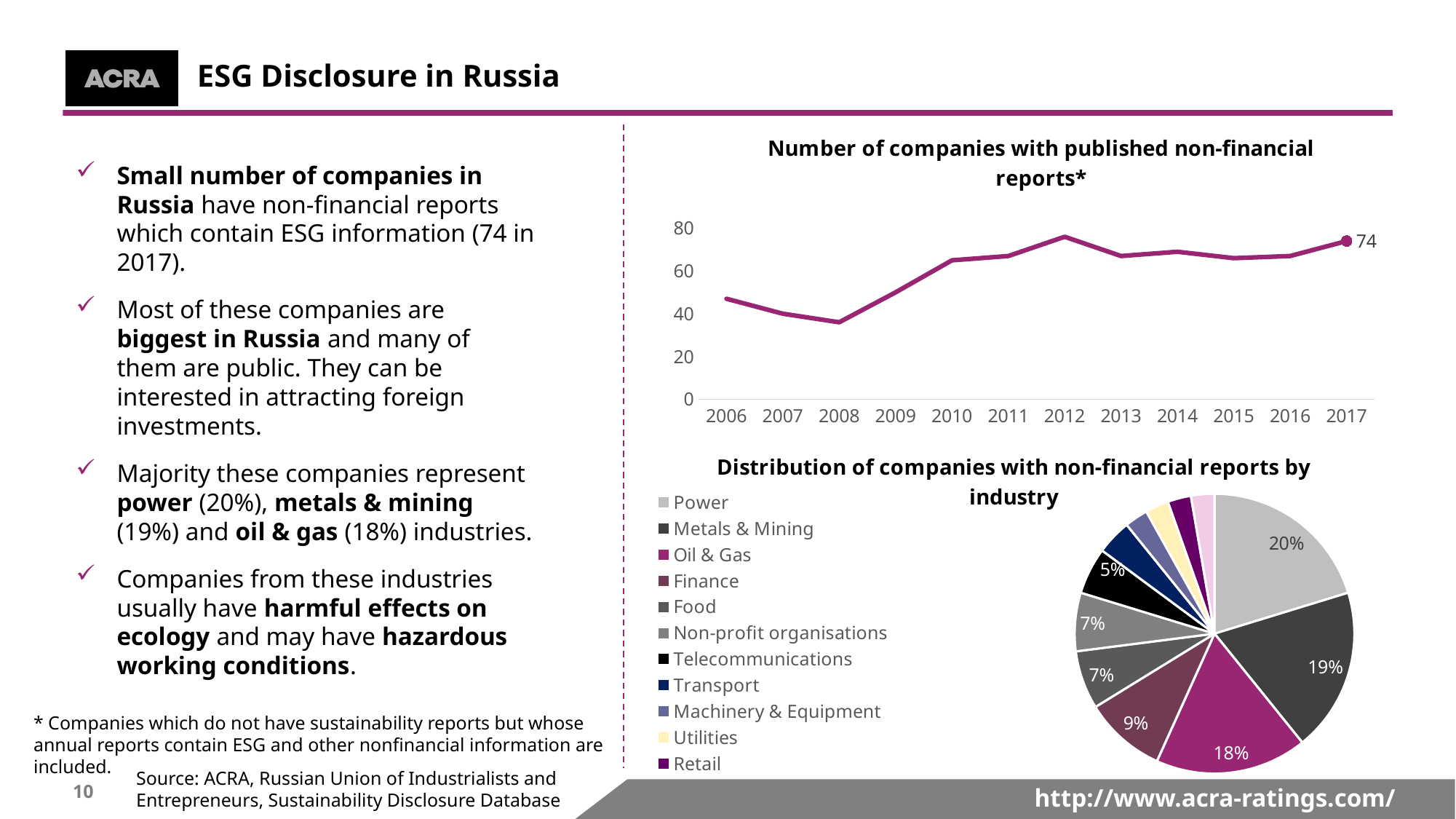
In the pie chart 'Distribution of companies with non-financial reports by industry', what share does Power have? 20% In the line chart 'Number of companies with published non-financial reports*', which year has the highest value? 2012 In the pie chart 'Distribution of companies with non-financial reports by industry', what is the difference between the Metals & Mining share and the Finance share? 10% In the line chart 'Number of companies with published non-financial reports*', what is the value for 2017? 74 What kind of chart is 'Number of companies with published non-financial reports*'? line chart In the line chart 'Number of companies with published non-financial reports*', how many years are shown on the x axis? 12 In the line chart 'Number of companies with published non-financial reports*', is the value for 2008 greater or less than 40? less In the pie chart 'Distribution of companies with non-financial reports by industry', which is larger, Finance or Telecommunications? Finance In the line chart 'Number of companies with published non-financial reports*', is the value for 2010 greater or less than 60? greater How many industries does the legend of the pie chart 'Distribution of companies with non-financial reports by industry' list? 11 In the pie chart 'Distribution of companies with non-financial reports by industry', what share does Oil & Gas have? 18% In the line chart 'Number of companies with published non-financial reports*', which year has the lowest value? 2008